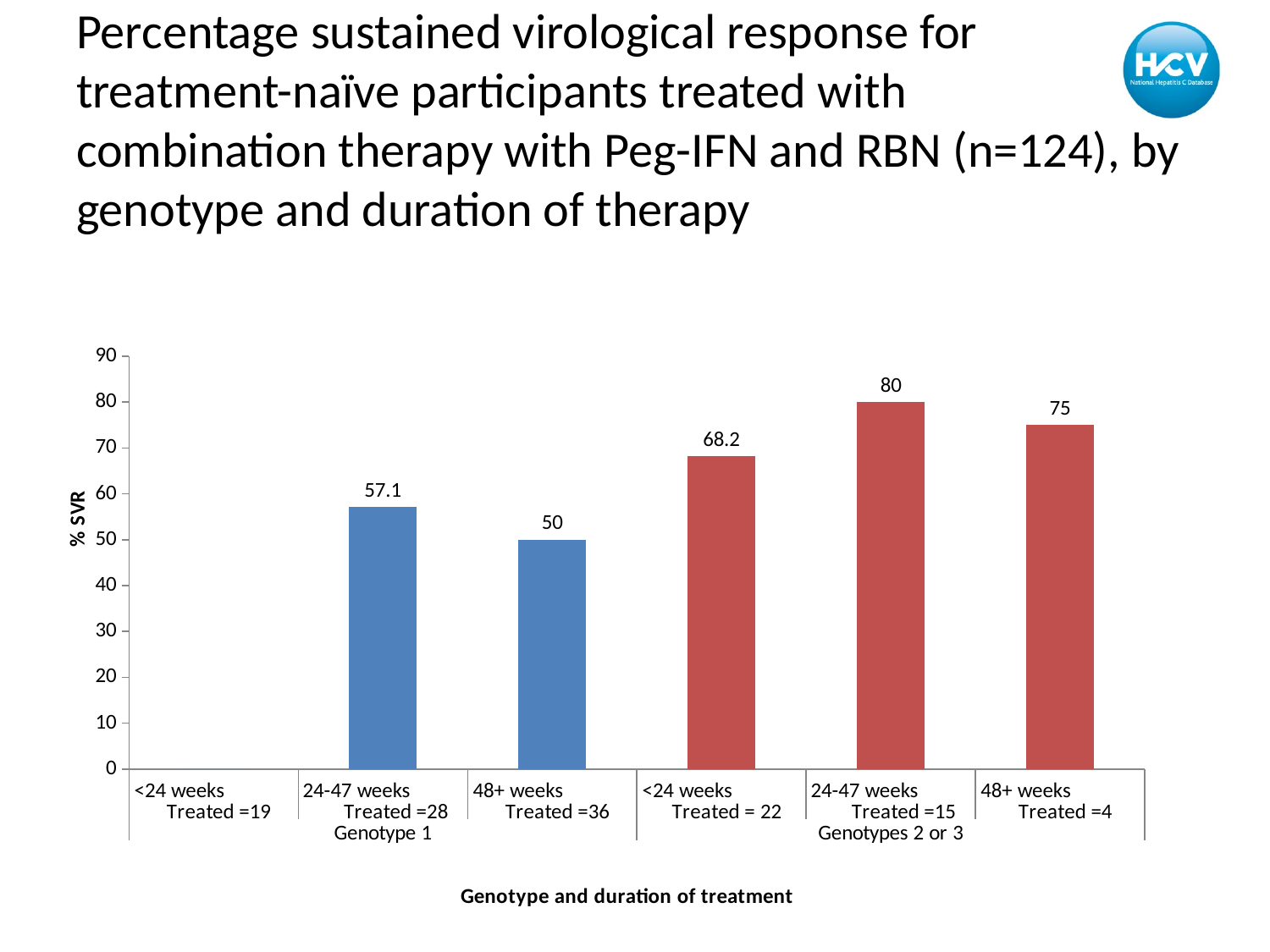
What is the % SVR for Genotypes 2 or 3 participants treated for 24-47 weeks? 80 What is the difference in % SVR between Genotypes 2 or 3 treated <24 weeks and Genotype 1 treated 24-47 weeks? 11.1 What is the label of the vertical axis of the chart? % SVR What kind of chart is shown on the slide? Bar chart Which is larger: the % SVR for Genotype 1 treated 24-47 weeks or Genotype 1 treated 48+ weeks? Genotype 1 treated 24-47 weeks What is the % SVR for Genotype 1 participants treated for 48+ weeks? 50 What is the % SVR for Genotypes 2 or 3 participants treated for 48+ weeks? 75 How many categories are shown on the x axis of the chart? 6 What is the % SVR for Genotypes 2 or 3 participants treated for <24 weeks? 68.2 Which category has the highest % SVR? Genotypes 2 or 3, 24-47 weeks What is the difference in % SVR between Genotypes 2 or 3 treated 24-47 weeks and Genotypes 2 or 3 treated 48+ weeks? 5 What is the % SVR for Genotype 1 participants treated for 24-47 weeks? 57.1